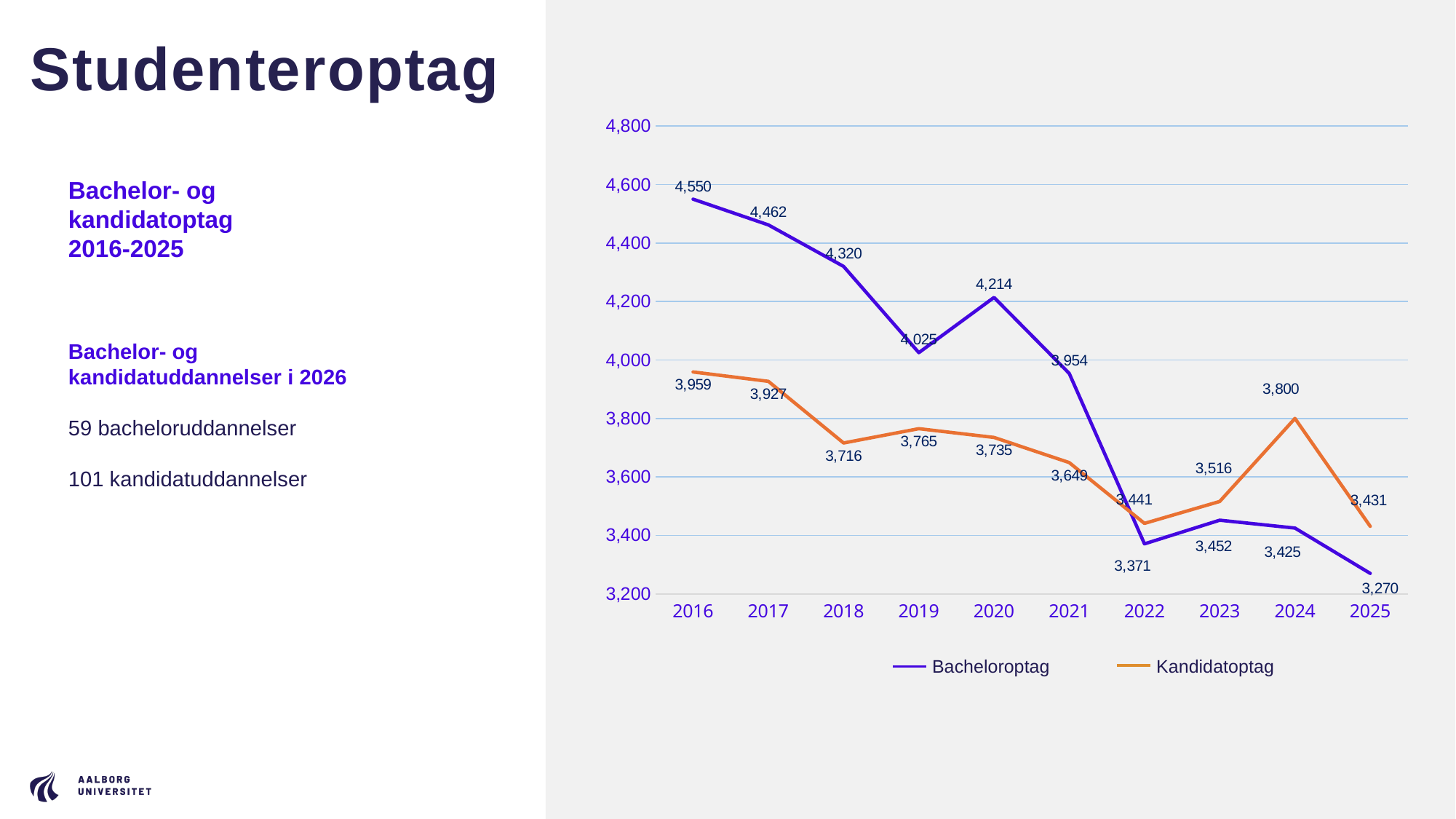
In which year is Kandidatoptag highest? 2016 How many years are plotted on the x axis? 10 What is the difference between Bacheloroptag and Kandidatoptag in 2020? 479 Which is larger in 2024, Bacheloroptag or Kandidatoptag? Kandidatoptag What kind of chart is shown on the slide? Line chart In which year is Bacheloroptag lowest? 2025 Which colour is used for the Kandidatoptag line? Orange What is the Kandidatoptag value for 2024? 3,800 Does Bacheloroptag generally rise or fall from 2016 to 2025? Fall How many series does the legend list? 2 What is the Bacheloroptag value for 2022? 3,371 What is the Bacheloroptag value for 2016? 4,550